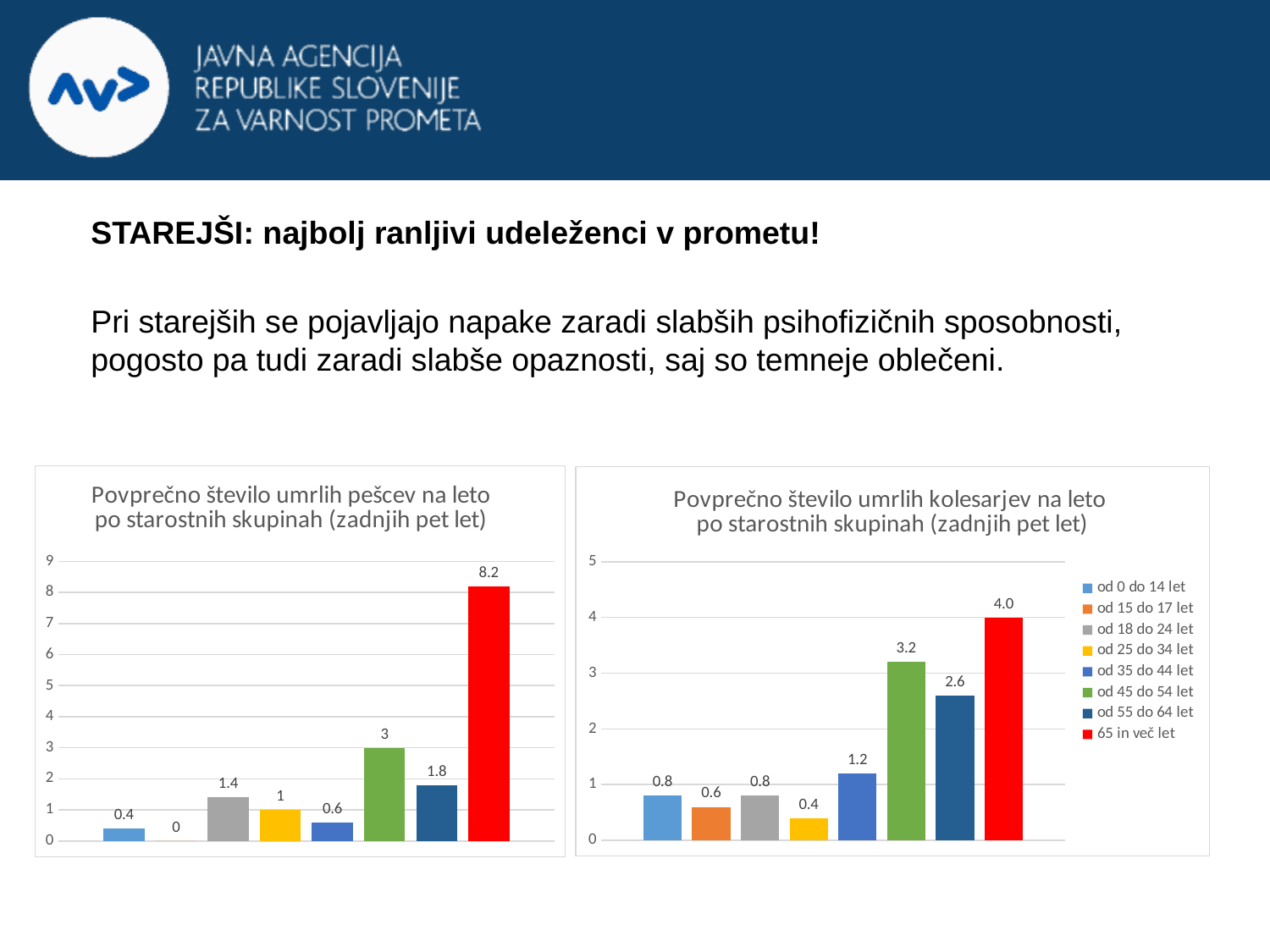
In the chart on the left, titled 'Povprečno število umrlih pešcev na leto po starostnih skupinah (zadnjih pet let)', what is the value of the second bar from the left? 0 In the chart on the left, titled 'Povprečno število umrlih pešcev na leto po starostnih skupinah (zadnjih pet let)', what is the highest value shown? 8.2 In the chart titled 'Povprečno število umrlih kolesarjev na leto po starostnih skupinah (zadnjih pet let)', what is the value for '65 in več let'? 4.0 In the chart titled 'Povprečno število umrlih kolesarjev na leto po starostnih skupinah (zadnjih pet let)', which age group has the highest value? 65 in več let In the chart titled 'Povprečno število umrlih kolesarjev na leto po starostnih skupinah (zadnjih pet let)', which age group has the lowest value? od 25 do 34 let What type of chart is the chart on the right, titled 'Povprečno število umrlih kolesarjev na leto po starostnih skupinah (zadnjih pet let)'? Bar chart In the chart titled 'Povprečno število umrlih kolesarjev na leto po starostnih skupinah (zadnjih pet let)', which is larger: the value for 'od 45 do 54 let' or 'od 55 do 64 let'? od 45 do 54 let How many entries does the legend of the chart titled 'Povprečno število umrlih kolesarjev na leto po starostnih skupinah (zadnjih pet let)' list? 8 In the chart titled 'Povprečno število umrlih kolesarjev na leto po starostnih skupinah (zadnjih pet let)', what is the difference between the values for '65 in več let' and 'od 55 do 64 let'? 1.4 How many bars are plotted in the chart on the left, titled 'Povprečno število umrlih pešcev na leto po starostnih skupinah (zadnjih pet let)'? 8 In the chart titled 'Povprečno število umrlih kolesarjev na leto po starostnih skupinah (zadnjih pet let)', what is the value for 'od 25 do 34 let'? 0.4 In the chart titled 'Povprečno število umrlih kolesarjev na leto po starostnih skupinah (zadnjih pet let)', what is the value for 'od 45 do 54 let'? 3.2